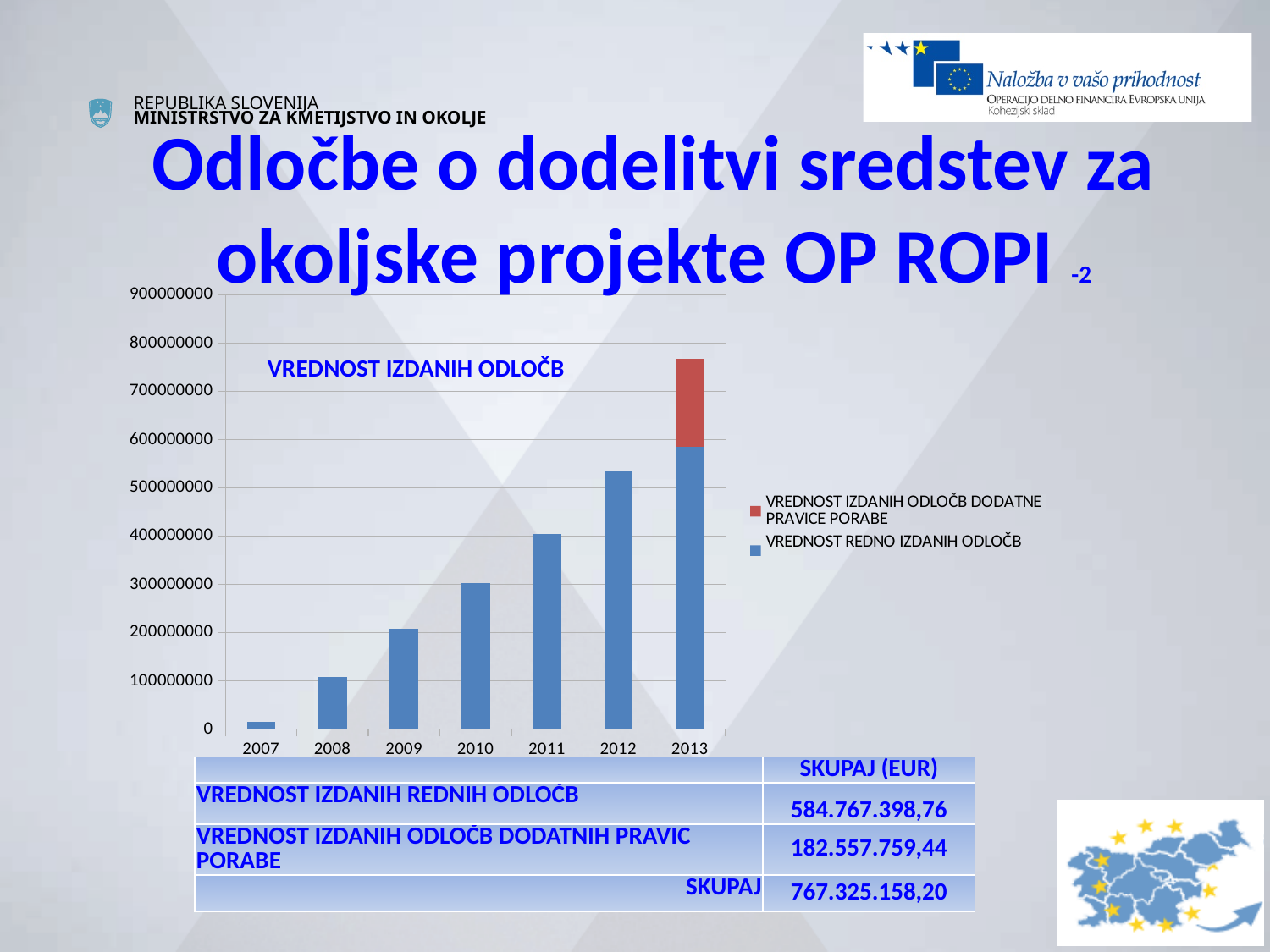
What is the title of the chart? VREDNOST IZDANIH ODLOČB Which bar is taller, 2011 or 2012? 2012 Is the value for 2010 greater or less than 400000000? less Is the total value for 2013 greater or less than 700000000? greater Is the value for 2012 greater or less than 500000000? greater Which year has the highest total bar in the chart? 2013 What kind of chart is shown on the slide? bar chart Which year has the lowest bar in the chart? 2007 How many years are shown on the x axis of the chart? 7 Which series is shown in red in the chart legend? VREDNOST IZDANIH ODLOČB DODATNE PRAVICE PORABE How many series does the chart legend list? 2 Do the bar values rise or fall from 2007 to 2013? rise